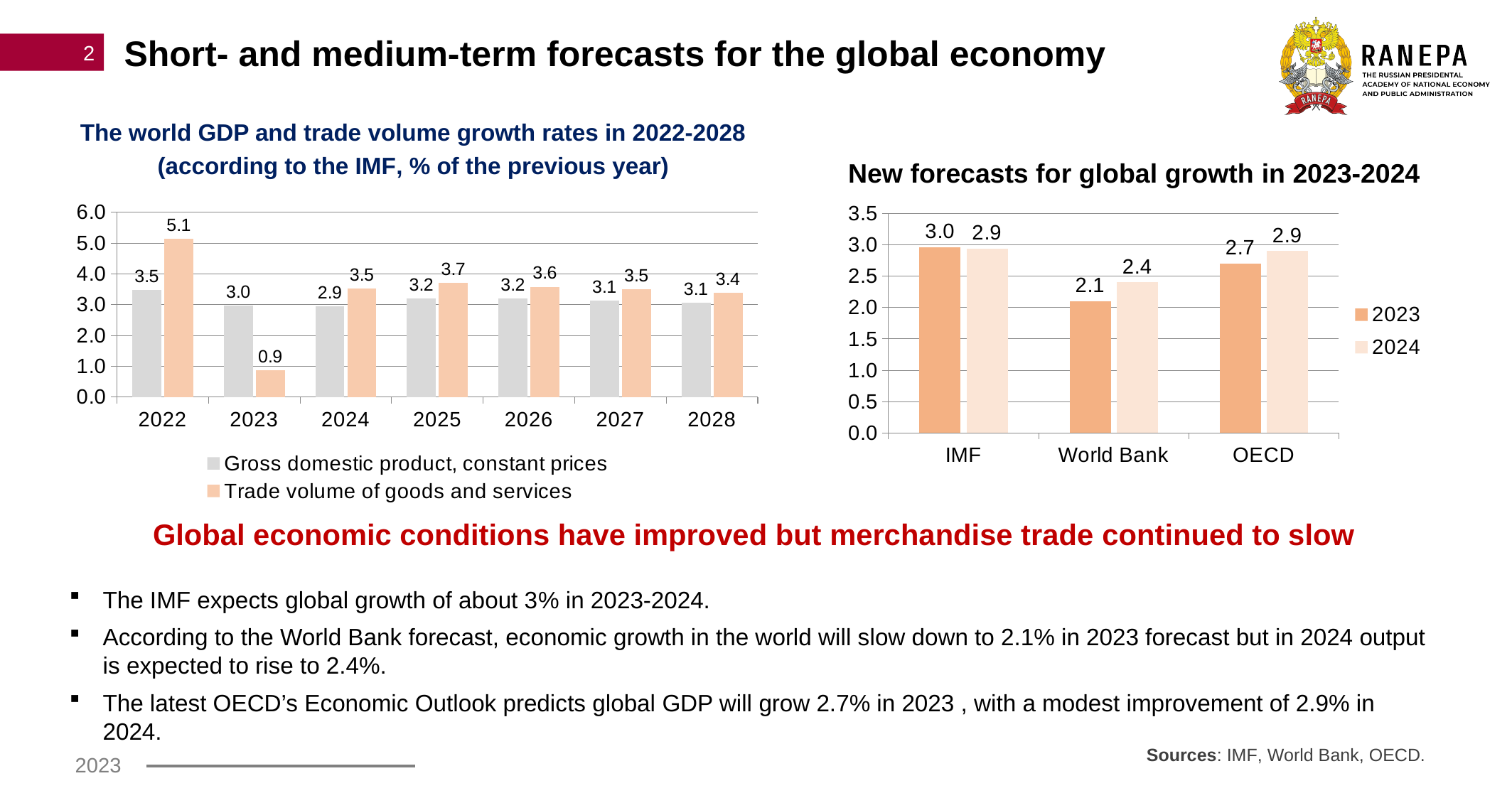
In the right chart (New forecasts for global growth in 2023-2024), what is the World Bank forecast for 2023? 2.1 In the right chart (New forecasts for global growth in 2023-2024), which is larger: the OECD forecast for 2023 or for 2024? 2024 What kind of chart is the right chart (New forecasts for global growth in 2023-2024)? Bar chart In the left chart (world GDP and trade volume growth rates), which year has the lowest trade volume growth rate? 2023 In the left chart (world GDP and trade volume growth rates), how many years are shown on the x axis? 7 In the right chart (New forecasts for global growth in 2023-2024), which organisation has the highest forecast for 2023? IMF In the left chart (world GDP and trade volume growth rates), what is the GDP growth rate for 2025? 3.2 In the left chart (world GDP and trade volume growth rates), how many series does the legend list? 2 In the left chart (world GDP and trade volume growth rates), which year has the highest GDP growth rate? 2022 In the left chart (world GDP and trade volume growth rates), what is the difference between the trade volume and GDP growth rates in 2022? 1.6 In the right chart (New forecasts for global growth in 2023-2024), what is the difference between the World Bank forecasts for 2024 and 2023? 0.3 In the left chart (world GDP and trade volume growth rates), what is the trade volume growth rate for 2022? 5.1